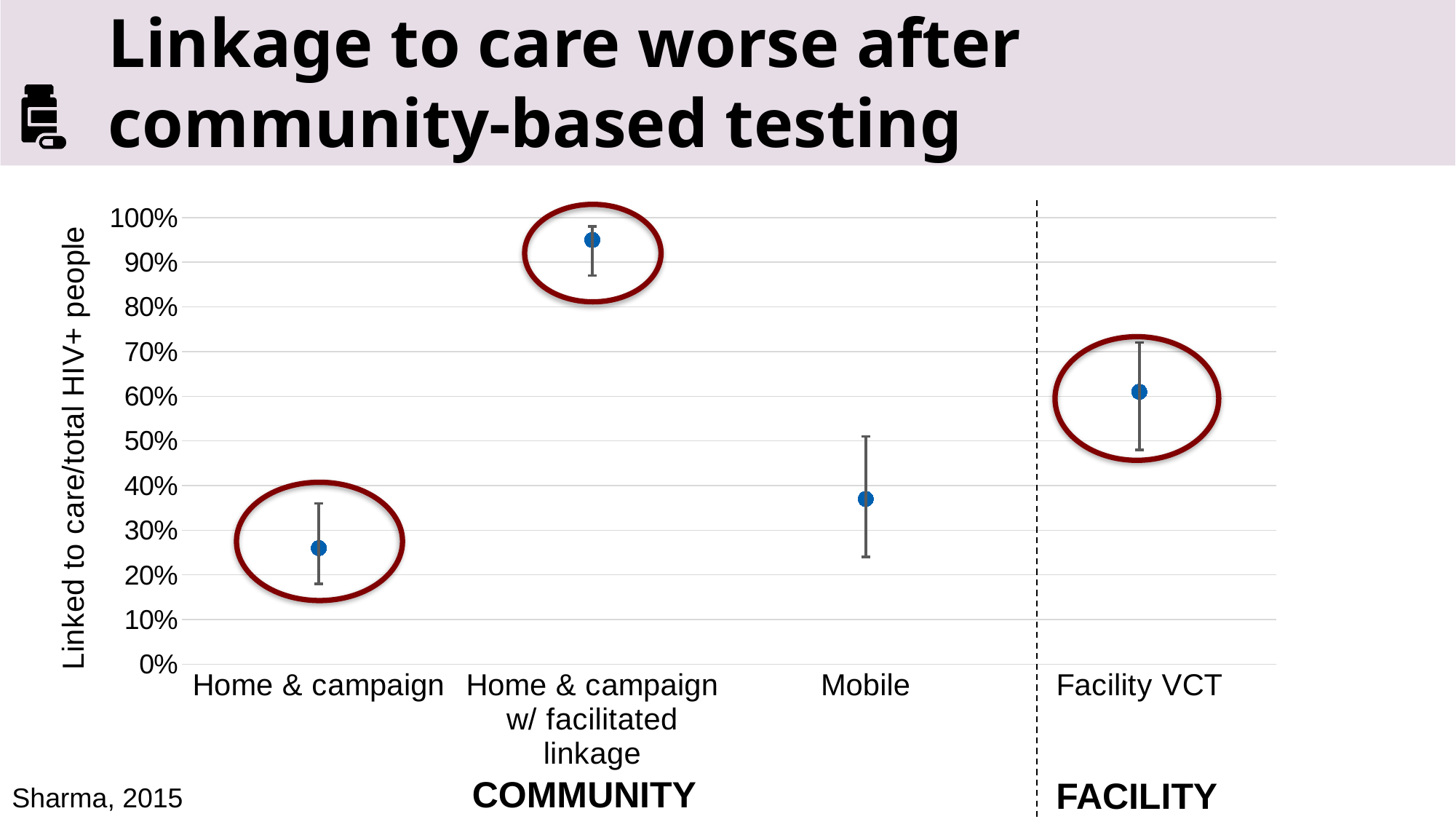
Which category is placed in the FACILITY group on the chart? Facility VCT What kind of chart is shown on the slide? Scatter chart with error bars Is the value for Mobile greater or less than 40%? less Which category has the highest linkage to care value? Home & campaign w/ facilitated linkage Which category has the lowest linkage to care value? Home & campaign Is the value for Facility VCT greater or less than 50%? greater Which has a higher linkage to care value, Mobile or Facility VCT? Facility VCT Which has a higher linkage to care value, Home & campaign or Mobile? Mobile Is the value for Home & campaign w/ facilitated linkage greater or less than 90%? greater What is the label of the y axis? Linked to care/total HIV+ people How many categories are plotted on the x axis of the chart? 4